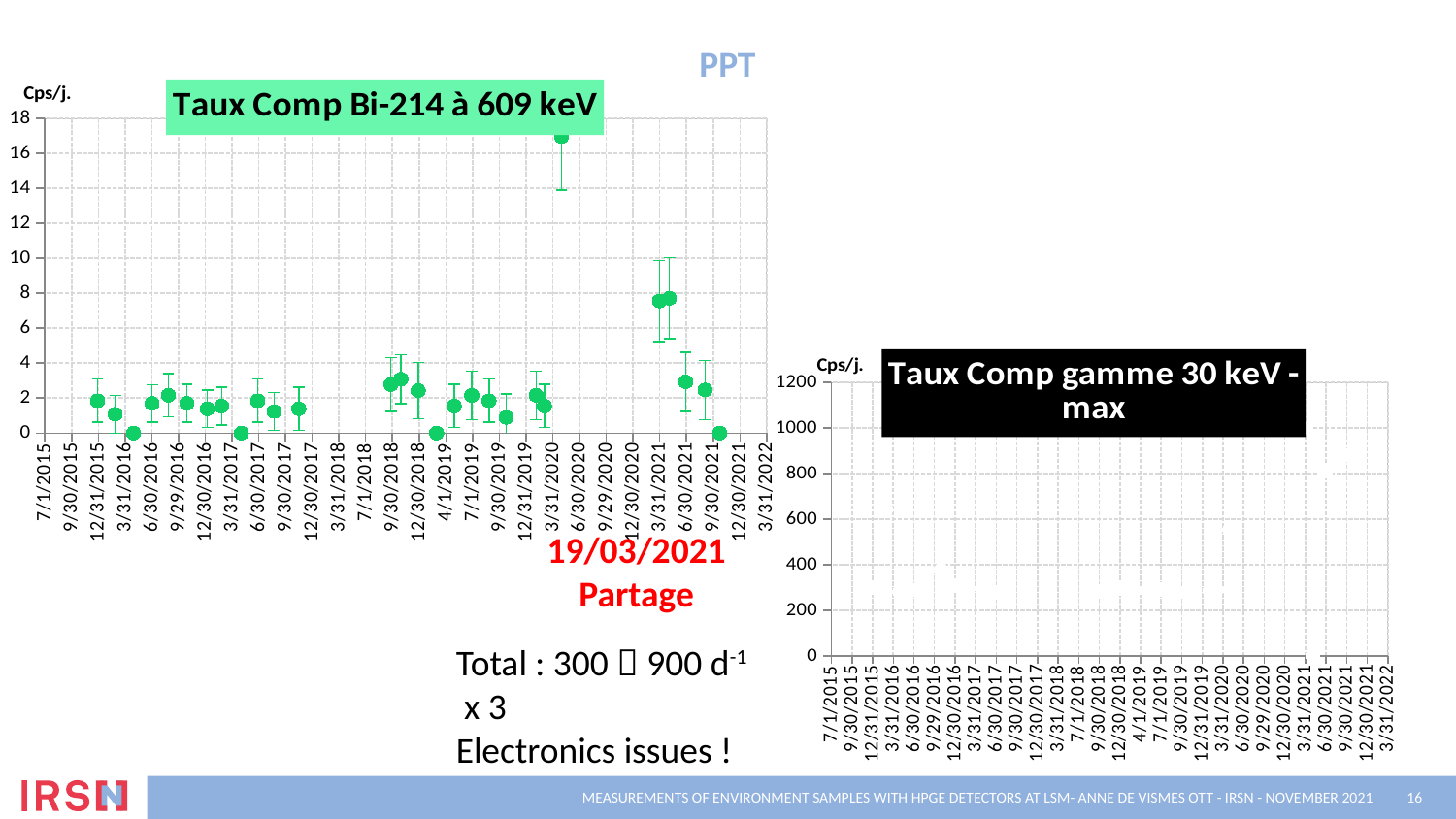
In the chart titled "Taux Comp Bi-214 à 609 keV", what is the highest value shown on the y axis? 18 In the chart titled "Taux Comp gamme 30 keV - max", what is the highest value shown on the y axis? 1200 What is the title of the chart on the right side of the slide? Taux Comp gamme 30 keV - max In the chart titled "Taux Comp Bi-214 à 609 keV", is the value at 3/31/2021 greater or less than 6? greater In the chart titled "Taux Comp Bi-214 à 609 keV", is the value at 12/31/2015 greater or less than 4? less In the chart titled "Taux Comp Bi-214 à 609 keV", which is larger: the value at 3/31/2021 or the value at 12/31/2015? 3/31/2021 What is the y-axis unit label on the chart titled "Taux Comp Bi-214 à 609 keV"? Cps/j. In the chart titled "Taux Comp Bi-214 à 609 keV", is the value at 9/30/2018 greater or less than 2? greater What kind of chart is the chart titled "Taux Comp Bi-214 à 609 keV"? scatter chart with error bars